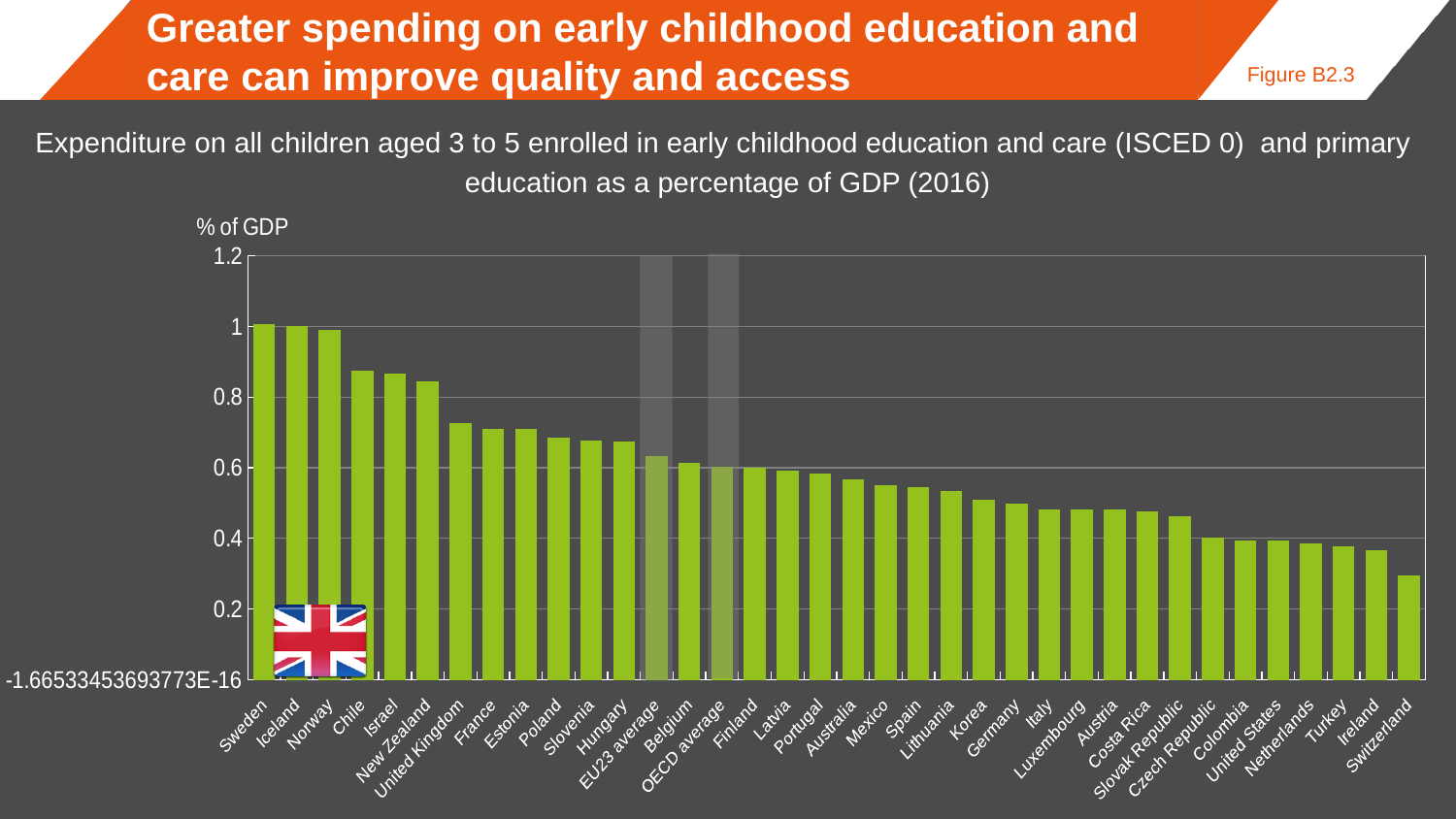
How many countries or averages are plotted along the x axis? 36 Do the values rise or fall moving from left to right along the x axis? fall What kind of chart is shown on the slide? bar chart Is the value for Switzerland greater or less than 0.4? less Is the value for the United Kingdom greater or less than 0.6? greater What is the label on the vertical axis of the chart? % of GDP Is the value for Chile greater or less than 0.8? greater Which has the larger value, Italy or the United Kingdom? United Kingdom Which has the larger value, Norway or Ireland? Norway Which country has the lowest expenditure as a percentage of GDP? Switzerland